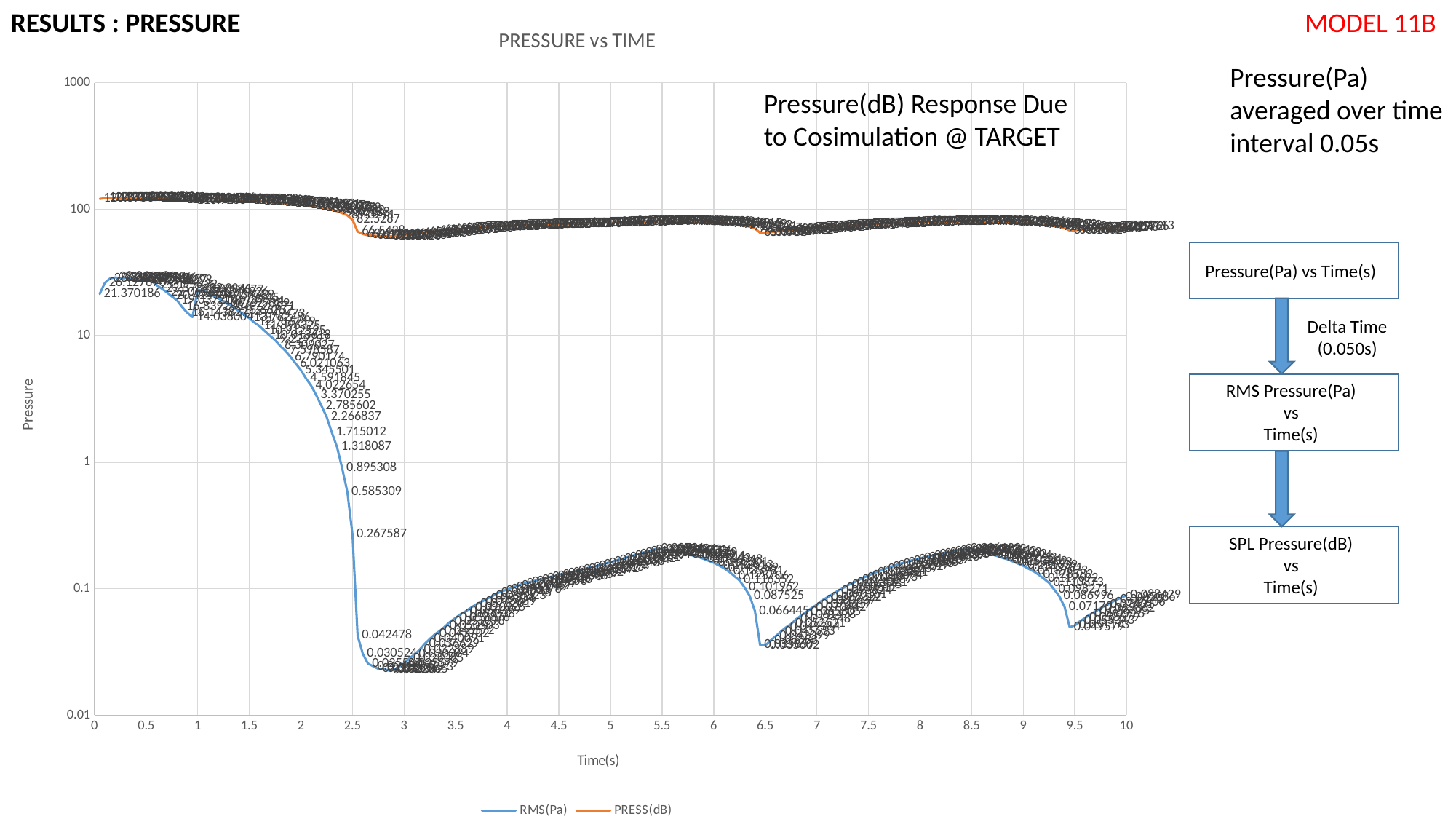
How many series does the chart legend list? 2 Between time 3.5 s and 5.5 s, does the RMS(Pa) series rise or fall? rise What are the two series named in the chart legend? RMS(Pa) and PRESS(dB) Is the value of the RMS(Pa) series at time 3 s greater or less than 0.1? less Between time 1 s and 2.5 s, does the RMS(Pa) series rise or fall? fall Is the value of the RMS(Pa) series at time 0.5 s greater or less than 10? greater Is the value of the PRESS(dB) series at time 5 s greater or less than 100? less At time 5 s, which series has the higher value, RMS(Pa) or PRESS(dB)? PRESS(dB) What kind of chart is shown on the slide? line chart What is the title of the chart? PRESSURE vs TIME Does the RMS(Pa) series reach its highest value near the start or near the end of the time range? near the start What value is printed as the first data label of the RMS(Pa) series at time 0? 21.370186